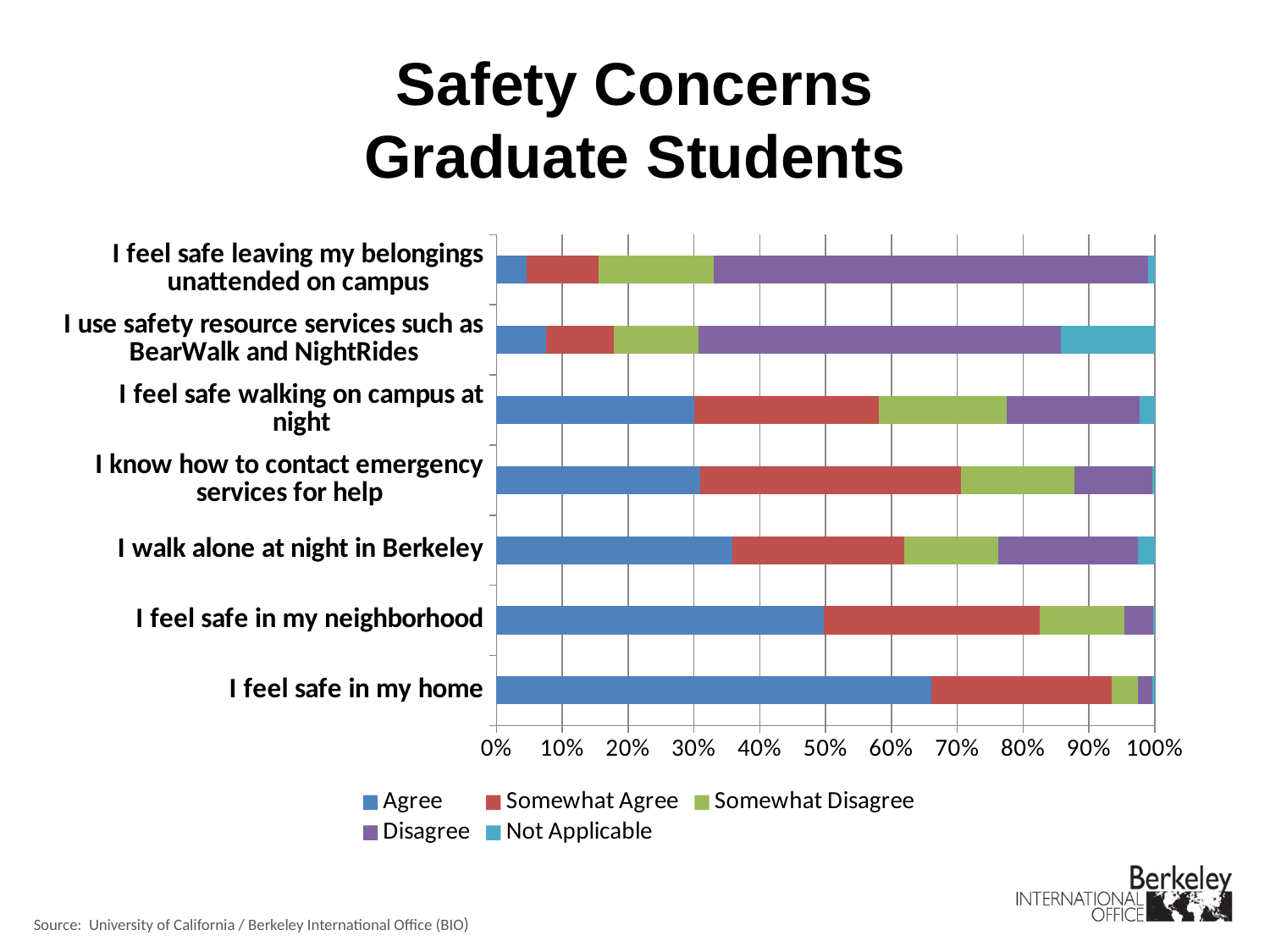
Which statement has the largest Disagree share? I feel safe leaving my belongings unattended on campus How many series does the legend list? 5 Is the Agree share for "I feel safe in my neighborhood" greater or less than 40%? greater What is the title of the chart on the slide? Safety Concerns Graduate Students Is the Agree share for "I feel safe in my home" greater or less than 60%? greater How many statements (categories) are plotted on the chart? 7 Which statement has the largest Agree share? I feel safe in my home Which series is listed first in the legend? Agree Is the Agree share for "I feel safe leaving my belongings unattended on campus" greater or less than 10%? less Which statement has the largest Not Applicable share? I use safety resource services such as BearWalk and NightRides What kind of chart is shown on the slide? bar chart Which has the larger Agree share: "I feel safe in my home" or "I feel safe in my neighborhood"? I feel safe in my home